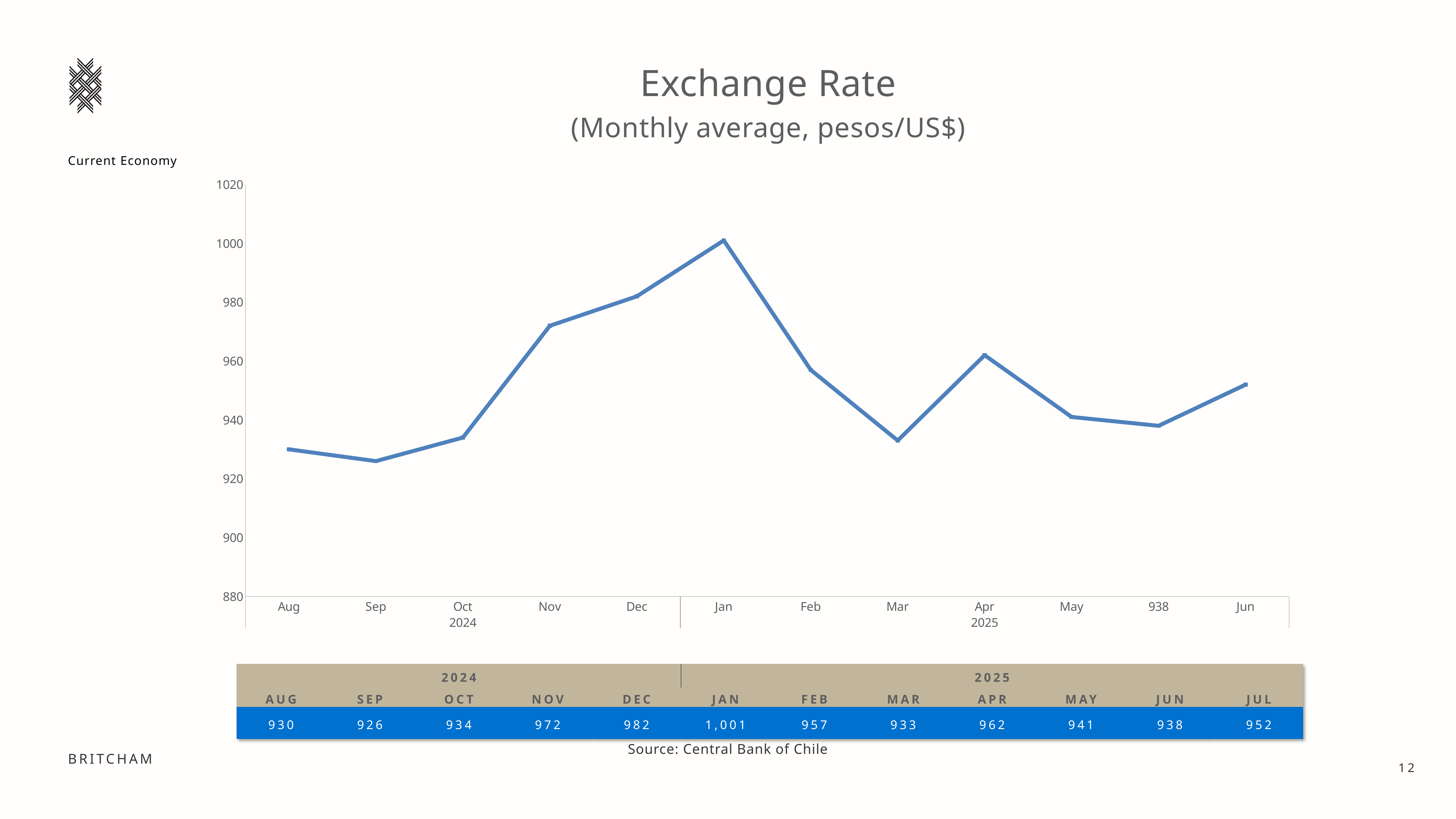
Which is larger, the exchange rate in Apr 2025 or in Oct 2024? Apr 2025 Does the exchange rate rise or fall from Sep 2024 to Jan 2025? rise What is the exchange rate value for Mar 2025? 933 By how much did the exchange rate fall from Jan 2025 to Feb 2025? 44 Which month has the highest exchange rate? Jan 2025 Is the exchange rate for Jan 2025 greater or less than 1000? greater Which month has the lowest exchange rate? Sep 2024 What is the exchange rate value for Jan 2025? 1,001 How many monthly data points are plotted on the chart? 12 What is the exchange rate value for Nov 2024? 972 What is the difference between the exchange rate in Dec 2024 and Nov 2024? 10 What kind of chart is shown on the slide? line chart